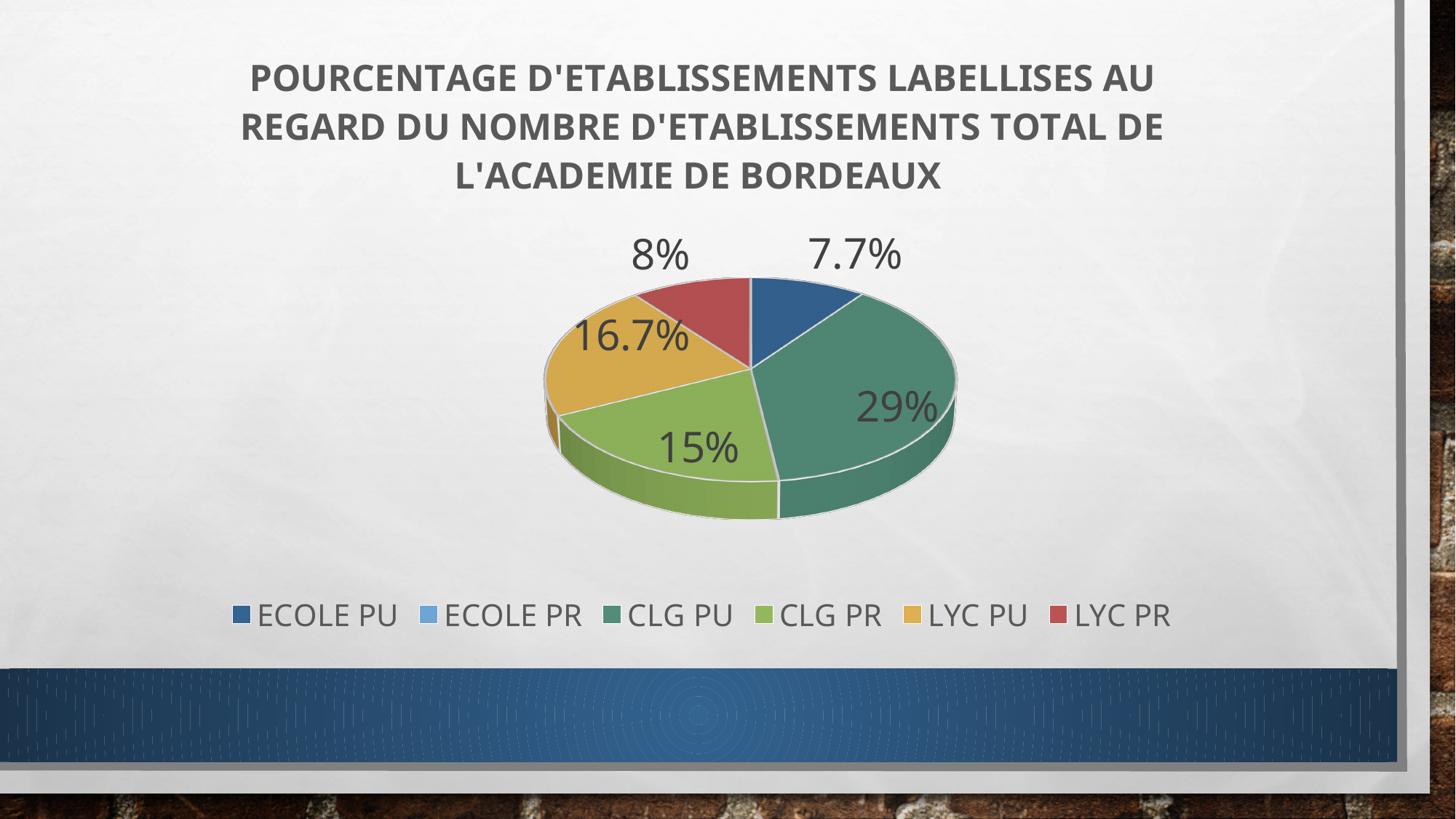
What is the value shown for ECOLE PU? 7.7% Which category has the highest value in the pie chart? CLG PU What colour is the CLG PU slice in the pie chart? Teal green Which is larger, the value for LYC PU or the value for CLG PR? LYC PU How many entries does the legend list? 6 Among the slices with a data label, which category has the smallest value? ECOLE PU What is the value shown for CLG PR? 15% What is the value shown for LYC PR? 8% What is the value shown for LYC PU? 16.7% What kind of chart is shown on the slide? Pie chart What is the value shown for CLG PU? 29% What is the difference between the values for CLG PU and CLG PR? 14 percentage points